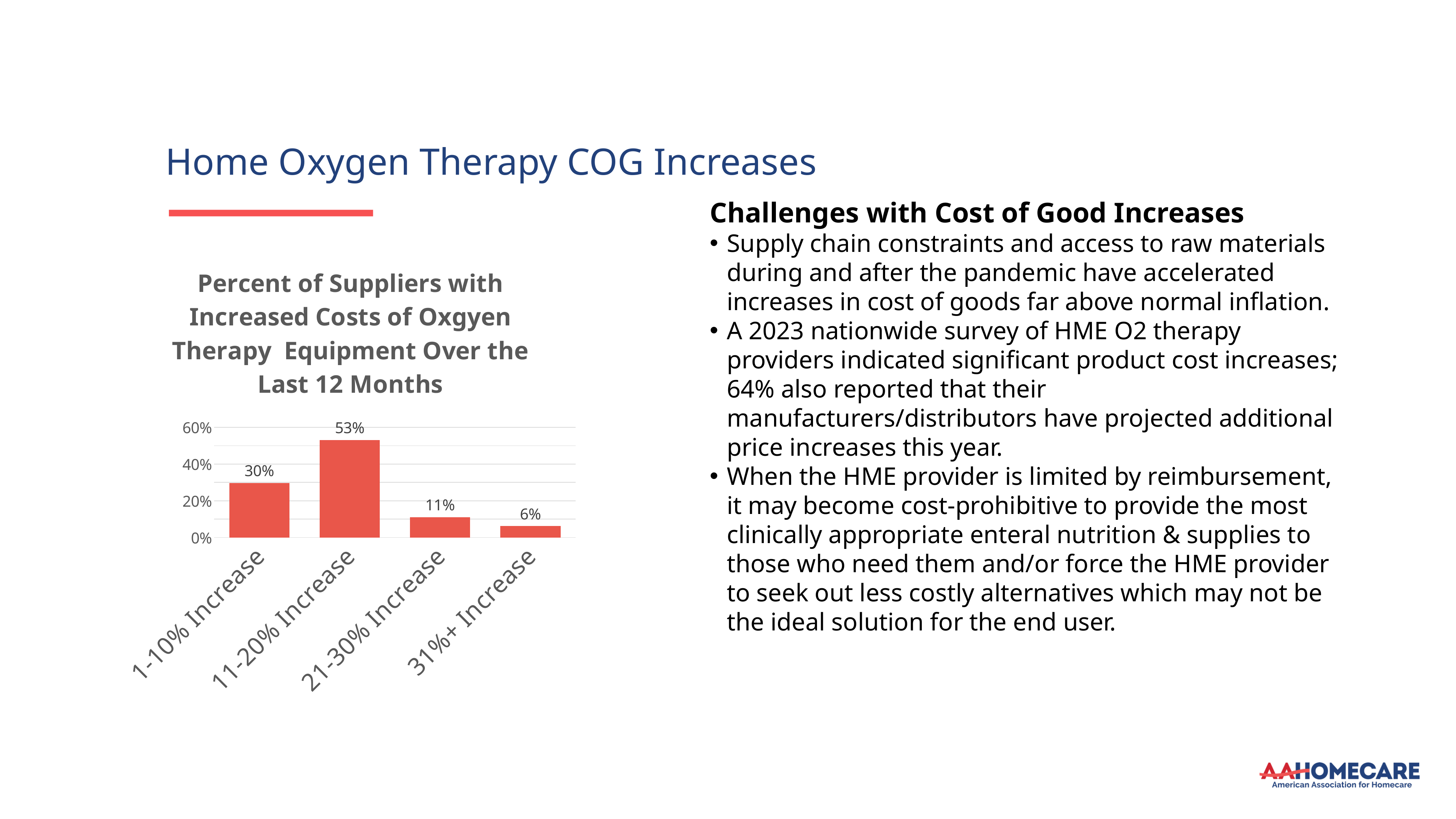
How many categories are shown on the x axis of the chart? 4 What is the title of the chart? Percent of Suppliers with Increased Costs of Oxgyen Therapy Equipment Over the Last 12 Months What percent of suppliers reported a 31%+ increase? 6% Which category has the highest percent of suppliers? 11-20% Increase Which category has the lowest percent of suppliers? 31%+ Increase Is the value for 11-20% Increase greater or less than 40%? greater What kind of chart is shown on the slide? bar chart What percent of suppliers reported a 1-10% increase? 30% What percent of suppliers reported an 11-20% increase? 53% What percent of suppliers reported a 21-30% increase? 11% Which is larger, the value for 21-30% Increase or 31%+ Increase? 21-30% Increase What is the difference between the 11-20% Increase and 1-10% Increase values? 23%